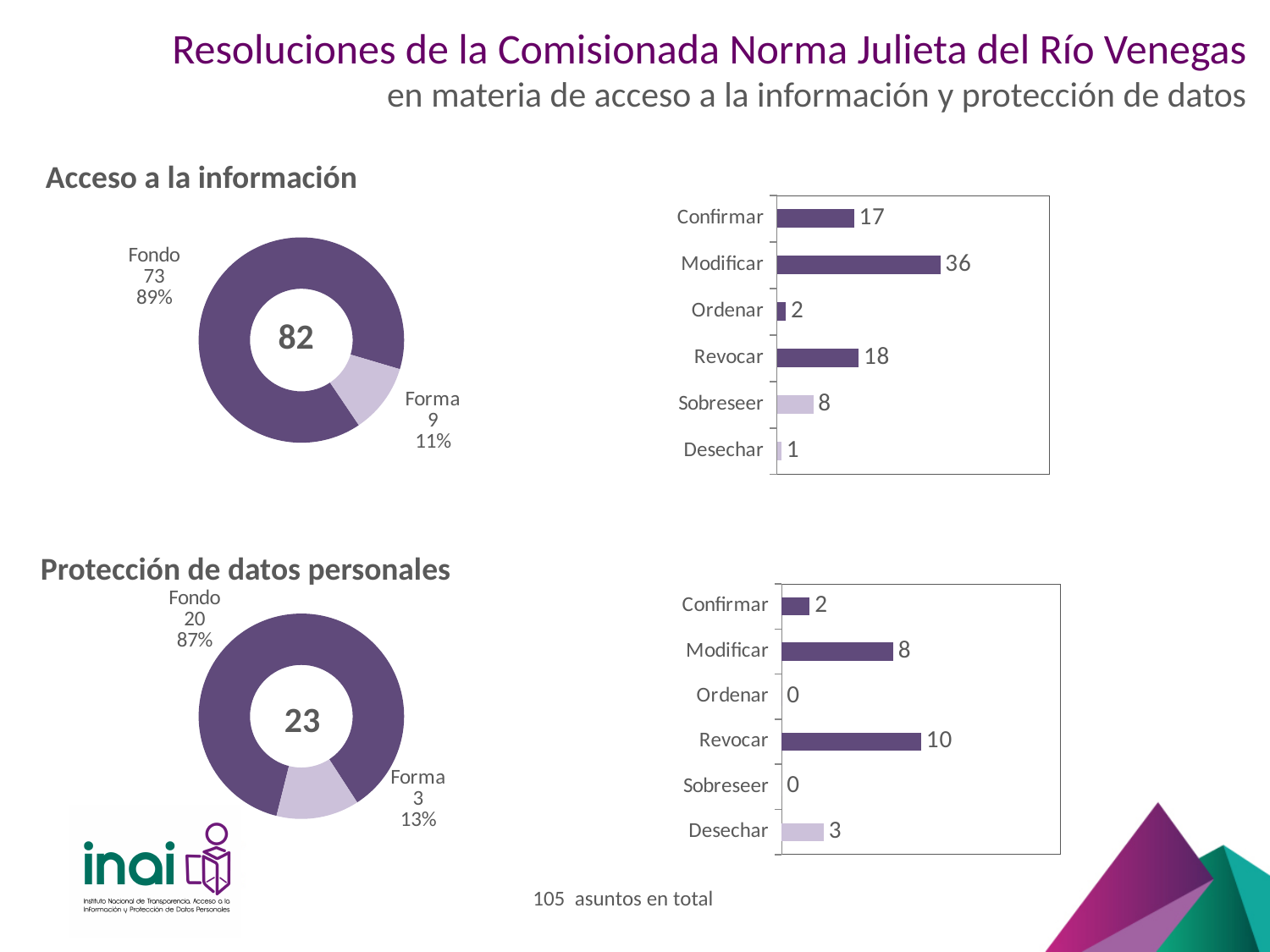
In the top-right bar chart (Acceso a la información), which category has the highest value? Modificar In the bottom-right bar chart (Protección de datos personales), what is the value for Revocar? 10 In the top-right bar chart (Acceso a la información), what is the value for Modificar? 36 In the top-right bar chart (Acceso a la información), which category has the lowest value? Desechar In the bottom-right bar chart (Protección de datos personales), which category has the highest value? Revocar In the top-right bar chart (Acceso a la información), how many categories are shown? 6 In the Acceso a la información donut chart, what is the total shown in the center? 82 In the Protección de datos personales donut chart, what is the value for Forma? 3 In the Acceso a la información donut chart, what share does Fondo represent? 89% In the bottom-right bar chart (Protección de datos personales), which is larger, Modificar or Desechar? Modificar In the top-right bar chart (Acceso a la información), what is the difference between Revocar and Confirmar? 1 What type of chart is the top-right chart on the slide? Bar chart